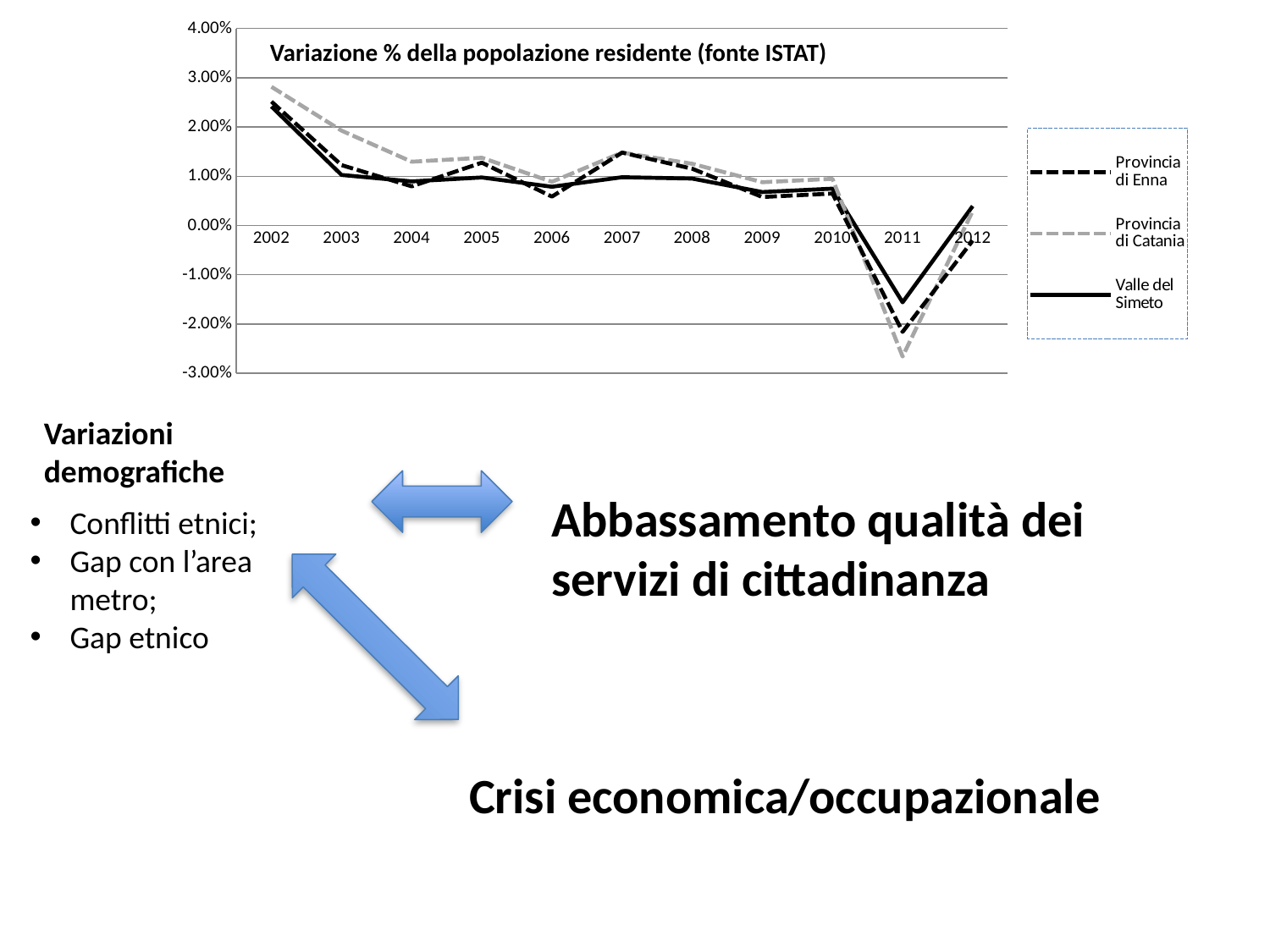
How many years are plotted along the x axis of the chart? 11 In 2011, which series has the lower value, Provincia di Catania or Valle del Simeto? Provincia di Catania Is the value for Valle del Simeto in 2011 greater or less than -1.00%? less What kind of chart is shown on the slide? line chart Is the value for Provincia di Catania in 2011 greater or less than -2.00%? less Is the value for Provincia di Catania in 2002 greater or less than 2.00%? greater How many series does the legend of the chart list? 3 Which series is drawn with a solid black line in the chart? Valle del Simeto What is the title of the chart? Variazione % della popolazione residente (fonte ISTAT) In which year does Provincia di Catania reach its lowest value? 2011 In which year does Provincia di Catania reach its highest value? 2002